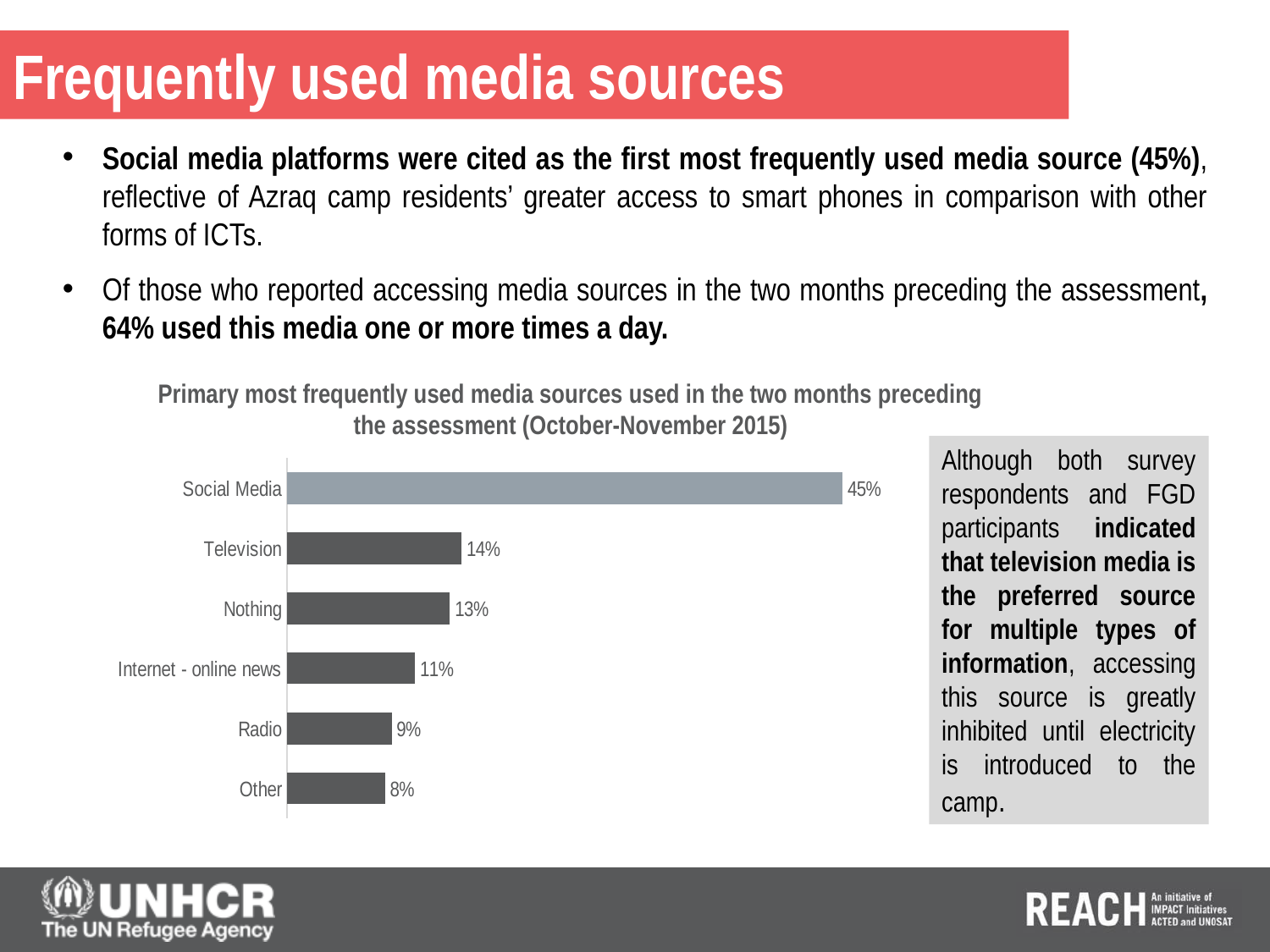
What percentage is shown for Radio? 9% What is the difference between the values for Nothing and Internet - online news? 2% What type of chart is shown on the slide? Bar chart What is the title of the chart? Primary most frequently used media sources used in the two months preceding the assessment (October-November 2015) Which category has the lowest value in the chart? Other What is the difference between the values for Social Media and Television? 31% What is the value shown for Television in the chart? 14% Which has a larger value, Television or Radio? Television Which media source has the highest value in the chart? Social Media How many categories are shown in the chart? 6 Which bar in the chart is shown in a lighter colour than the others? Social Media What percentage of respondents cited Social Media as their primary most frequently used media source? 45%